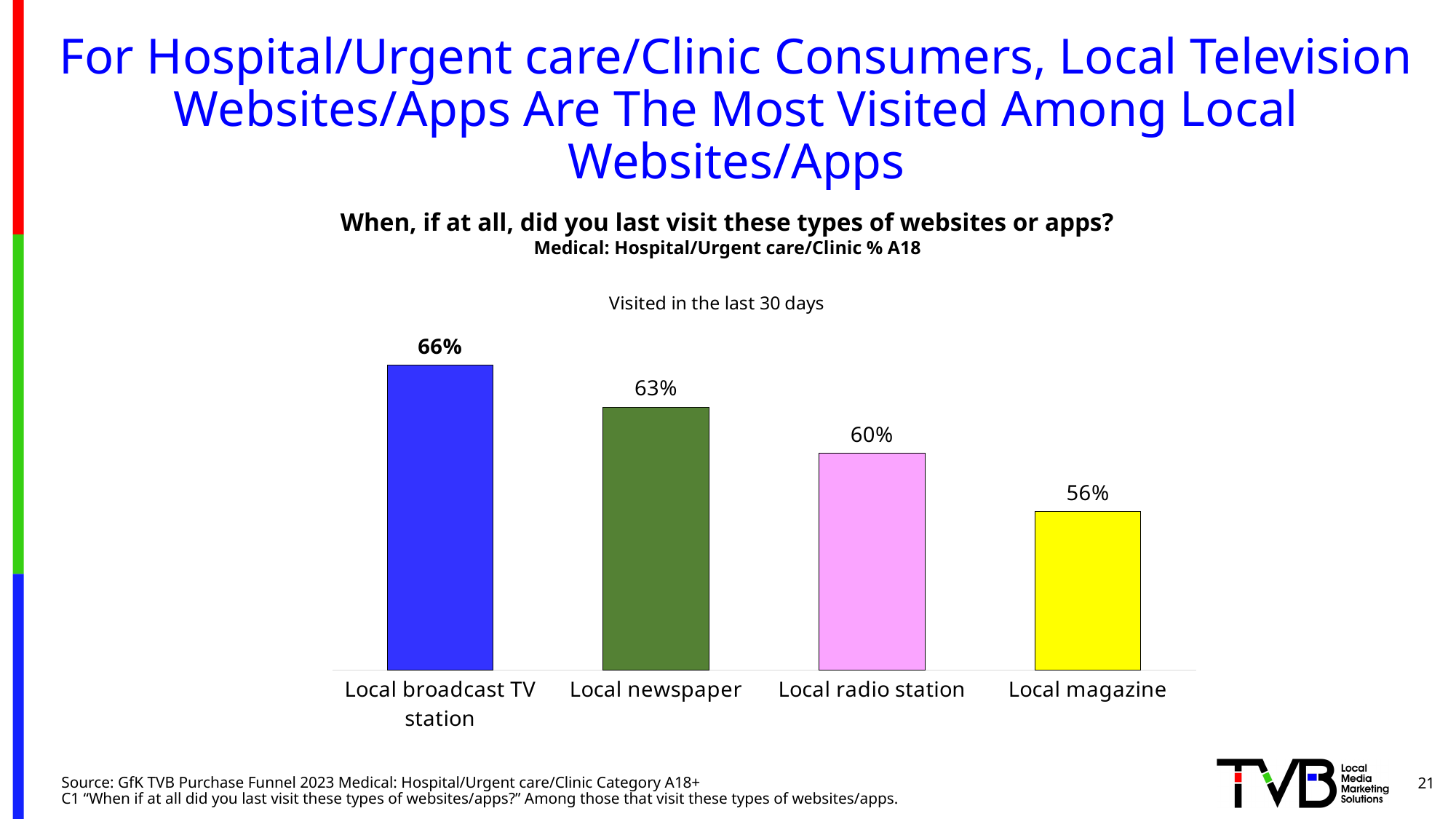
What is the value shown for Local newspaper? 63% Which category has the lowest value? Local magazine How many categories are shown in the chart? 4 What is the difference in percentage points between Local broadcast TV station and Local magazine? 10 Do the values rise or fall from left to right across the categories? Fall What is the value shown for Local magazine? 56% What is the difference in percentage points between Local newspaper and Local radio station? 3 What is the value shown for Local radio station? 60% Which category has the highest value? Local broadcast TV station Which is larger, the value for Local newspaper or the value for Local magazine? Local newspaper What kind of chart is shown on the slide? Bar chart What percentage of Hospital/Urgent care/Clinic consumers visited a local broadcast TV station website or app in the last 30 days? 66%